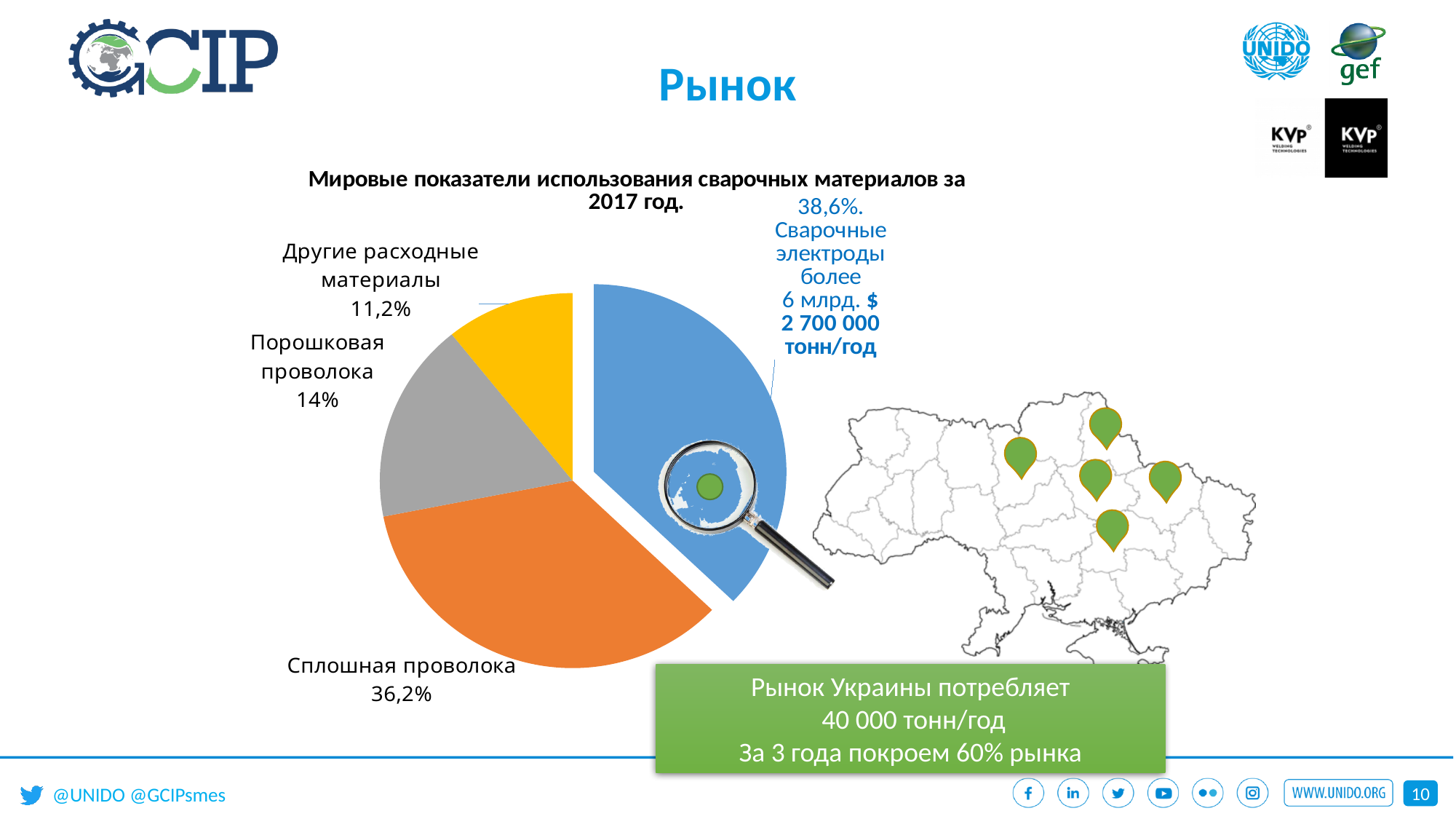
What share of the pie is labelled for Сплошная проволока? 36,2% What share of the pie is labelled for Сварочные электроды? 38,6% What is the difference in percentage points between Сварочные электроды and Сплошная проволока? 2,4 What share of the pie is labelled for Порошковая проволока? 14% What kind of chart is shown on the slide? Pie chart Which has a larger share: Порошковая проволока or Другие расходные материалы? Порошковая проволока What colour is the slice for Сплошная проволока? Orange Which category has the largest share of the pie? Сварочные электроды How many slices does the pie chart have? 4 Which category has the smallest share of the pie? Другие расходные материалы What is the title of the pie chart? Мировые показатели использования сварочных материалов за 2017 год.